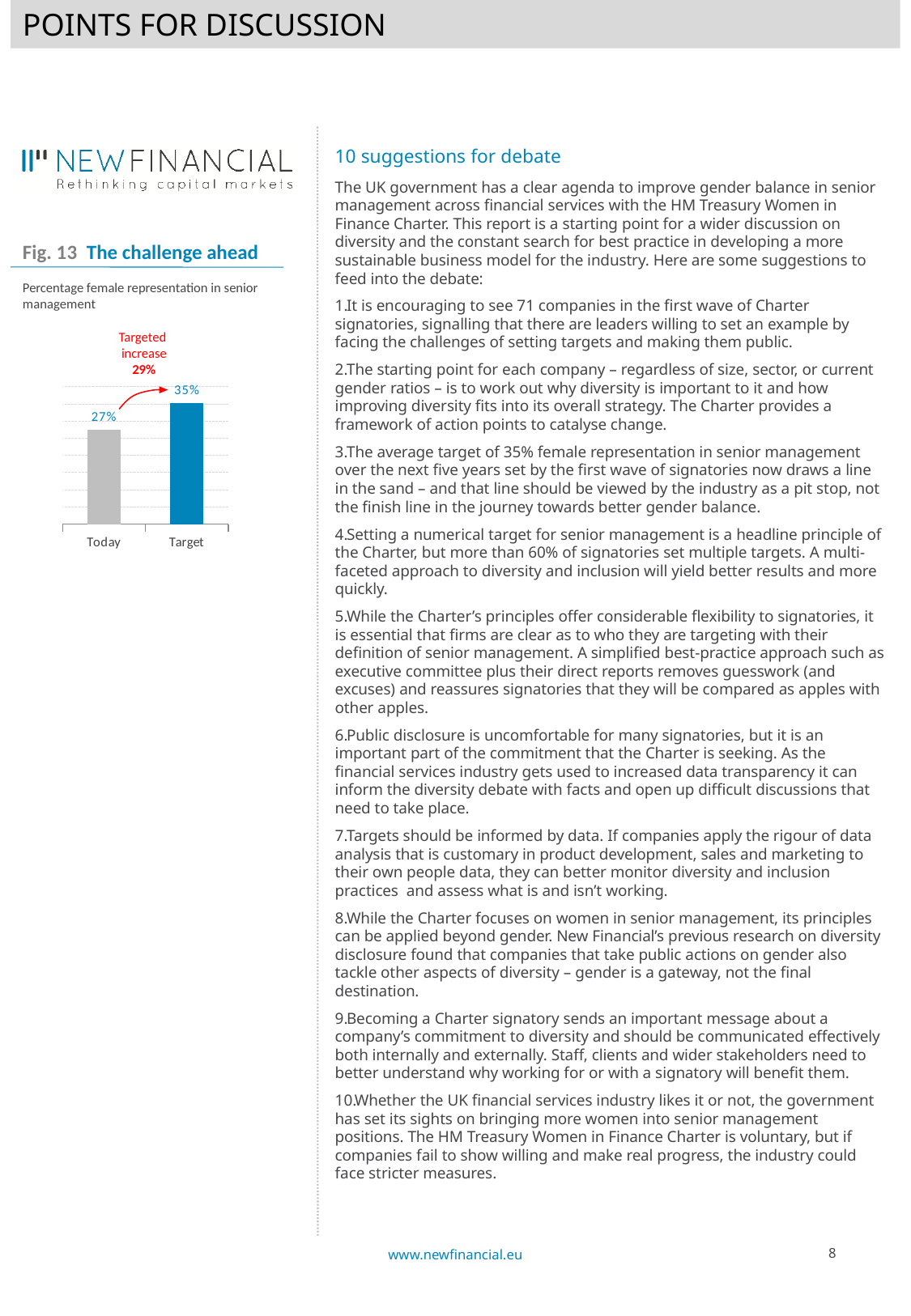
Which category has the higher value in the Fig. 13 chart, Today or Target? Target What targeted increase is annotated on the Fig. 13 chart? 29% What is the title of Fig. 13? The challenge ahead Which category has the highest value in the Fig. 13 chart? Target Do the values rise or fall from Today to Target in the Fig. 13 chart? Rise By how many percentage points does the Target value exceed the Today value in the Fig. 13 chart? 8 percentage points What type of chart is Fig. 13? Bar chart Which category has the lowest value in the Fig. 13 chart? Today What is the value for Today in the Fig. 13 chart? 27% How many categories are shown in the Fig. 13 chart? 2 What is the value for Target in the Fig. 13 chart? 35% What does the Fig. 13 chart measure, according to its subtitle? Percentage female representation in senior management